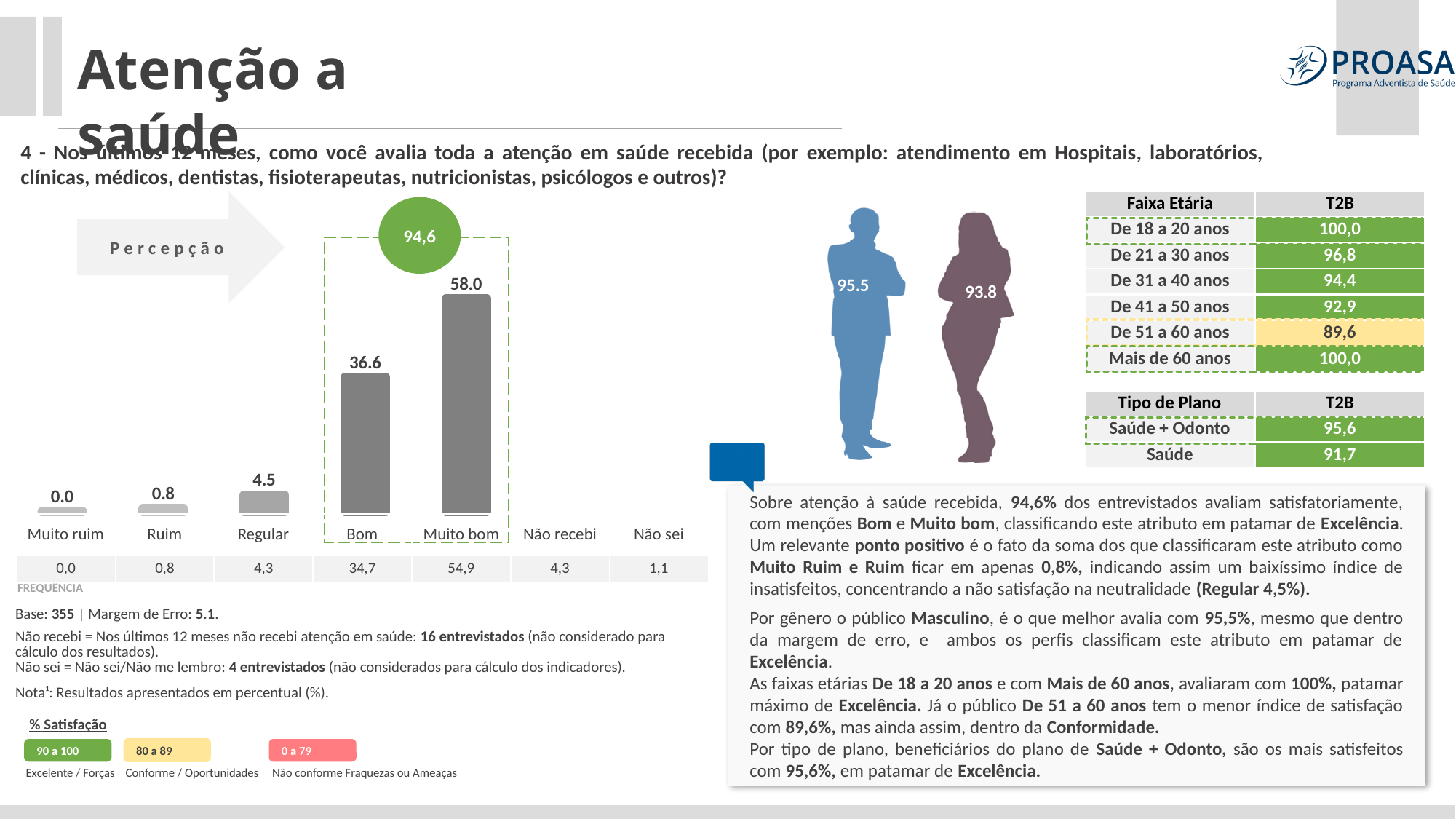
What is the value shown for 'Bom' in the bar chart? 36.6 Which category has the highest bar in the chart? Muito bom What is the value shown for 'Muito bom' in the bar chart? 58.0 What is the value shown for 'Regular' in the bar chart? 4.5 What is the value shown for 'Ruim' in the bar chart? 0.8 What is the difference between the values for 'Muito bom' and 'Bom'? 21.4 What type of chart is shown on the left of the slide? bar chart What value is printed in the green circle above the dashed box in the bar chart? 94,6 What is the combined value of the 'Bom' and 'Muito bom' bars? 94.6 How many categories are labelled along the x axis of the bar chart? 7 Which category has the lowest value in the bar chart? Muito ruim Which is larger in the bar chart, 'Bom' or 'Regular'? Bom